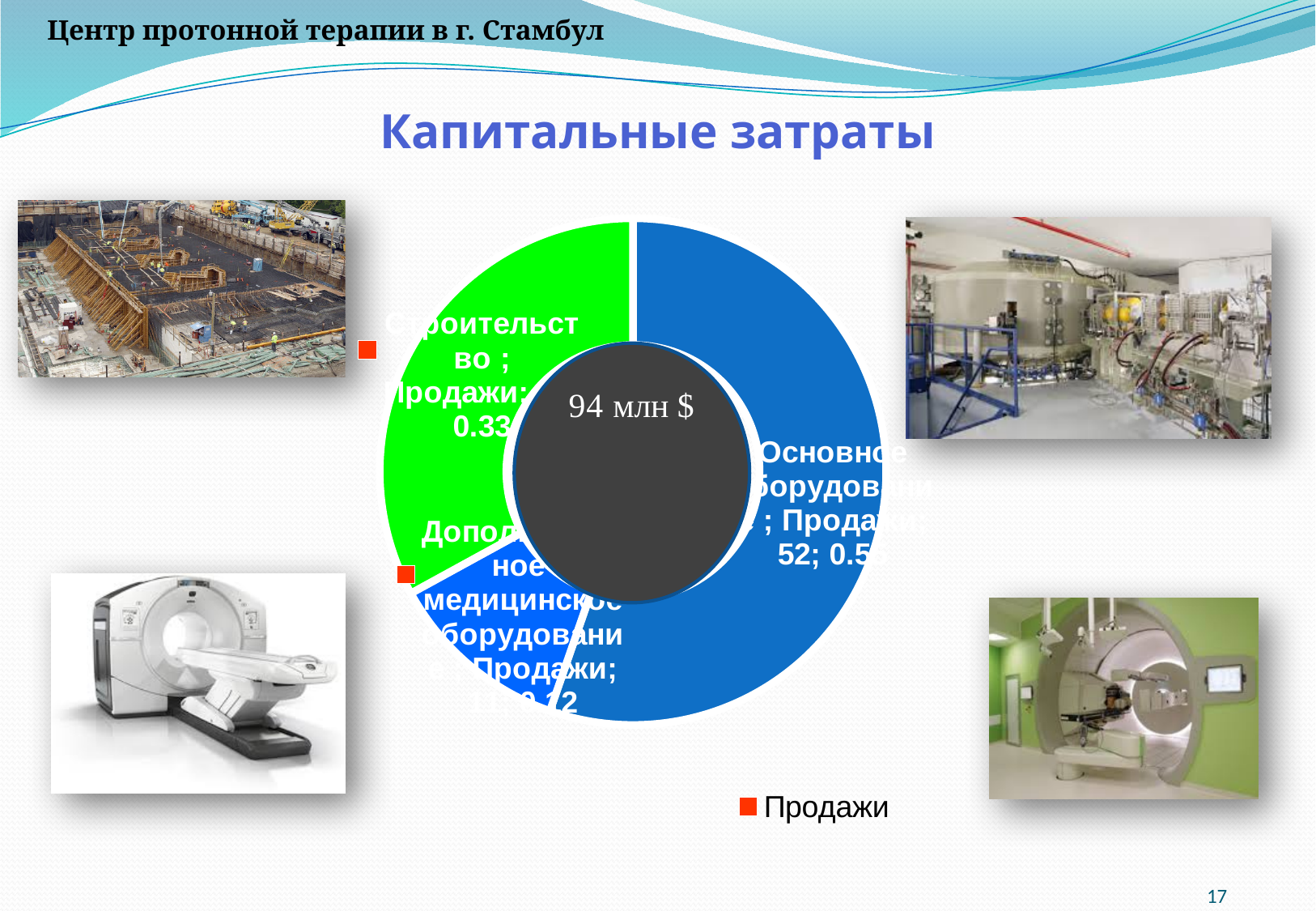
What share of the pie does Строительство take? 0.33 Which category has the largest slice? Основное оборудование What is the title of the chart? Капитальные затраты Which slice is larger: Строительство or Дополнительное медицинское оборудование? Строительство How many slices does the pie chart have? 3 What series name is shown in the legend? Продажи What value is shown for Основное оборудование? 52 What share of the pie does Основное оборудование take? 0.55 How many series does the legend list? 1 What kind of chart is shown on the slide? Doughnut chart Which category has the smallest slice? Дополнительное медицинское оборудование What share of the pie does Дополнительное медицинское оборудование take? 0.12